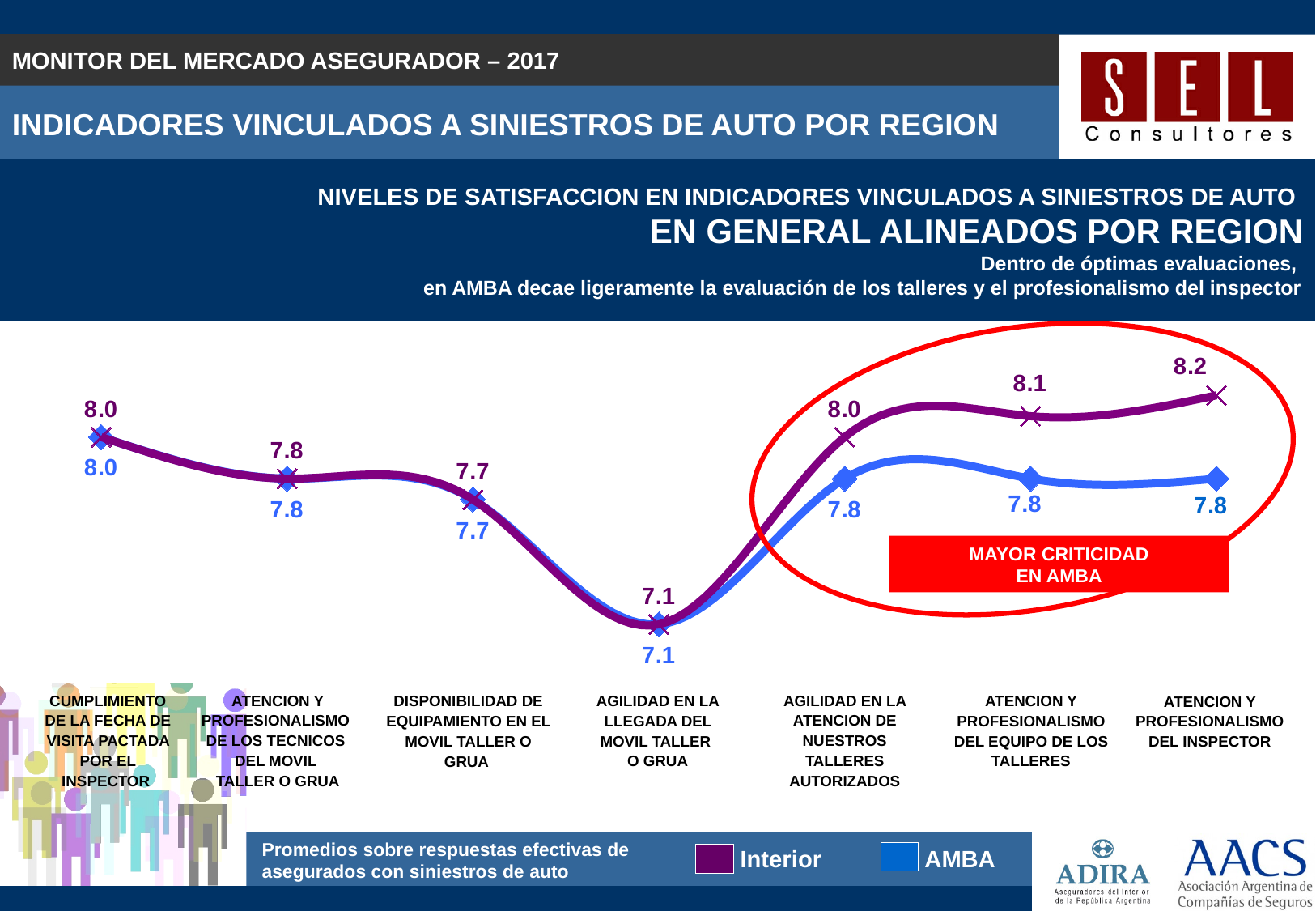
For ATENCION Y PROFESIONALISMO DEL EQUIPO DE LOS TALLERES, which series has the larger value, Interior or AMBA? Interior What is the difference between the Interior and AMBA values for ATENCION Y PROFESIONALISMO DEL INSPECTOR? 0.4 Which category has the highest value for the Interior series? ATENCION Y PROFESIONALISMO DEL INSPECTOR How many series does the legend list? 2 What is the AMBA value for AGILIDAD EN LA ATENCION DE NUESTROS TALLERES AUTORIZADOS? 7.8 What kind of chart is shown on the slide? Line chart What is the Interior value for ATENCION Y PROFESIONALISMO DEL INSPECTOR? 8.2 What is the AMBA value for AGILIDAD EN LA LLEGADA DEL MOVIL TALLER O GRUA? 7.1 What is the Interior value for ATENCION Y PROFESIONALISMO DEL EQUIPO DE LOS TALLERES? 8.1 How many categories are plotted on the chart? 7 Which category has the lowest value for the Interior series? AGILIDAD EN LA LLEGADA DEL MOVIL TALLER O GRUA Which colour represents the AMBA series in the legend? Blue